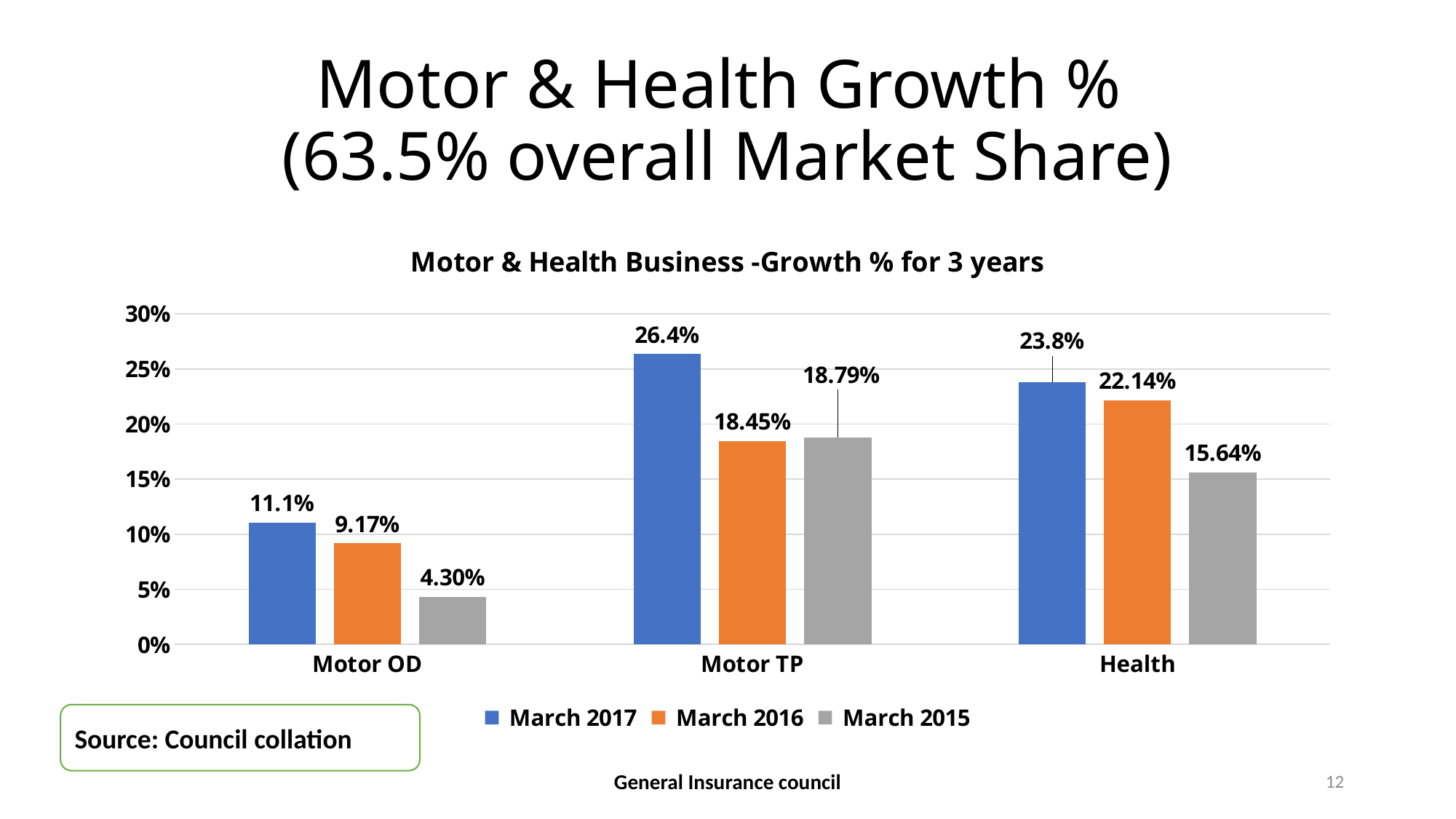
Which category has the highest March 2017 growth %? Motor TP What is the March 2016 growth % for Health? 22.14% What is the title of the chart? Motor & Health Business -Growth % for 3 years What kind of chart is shown on the slide? Bar chart What is the March 2015 growth % for Motor OD? 4.30% Is the March 2017 value for Health greater or less than 20%? greater What is the difference between the March 2017 and March 2016 growth % for Motor OD? 1.93% Which category has the lowest March 2015 growth %? Motor OD What is the March 2017 growth % for Motor TP? 26.4% For Motor TP, which is larger: the March 2016 value or the March 2015 value? March 2015 How many series does the legend list? 3 How many categories are shown on the x axis? 3